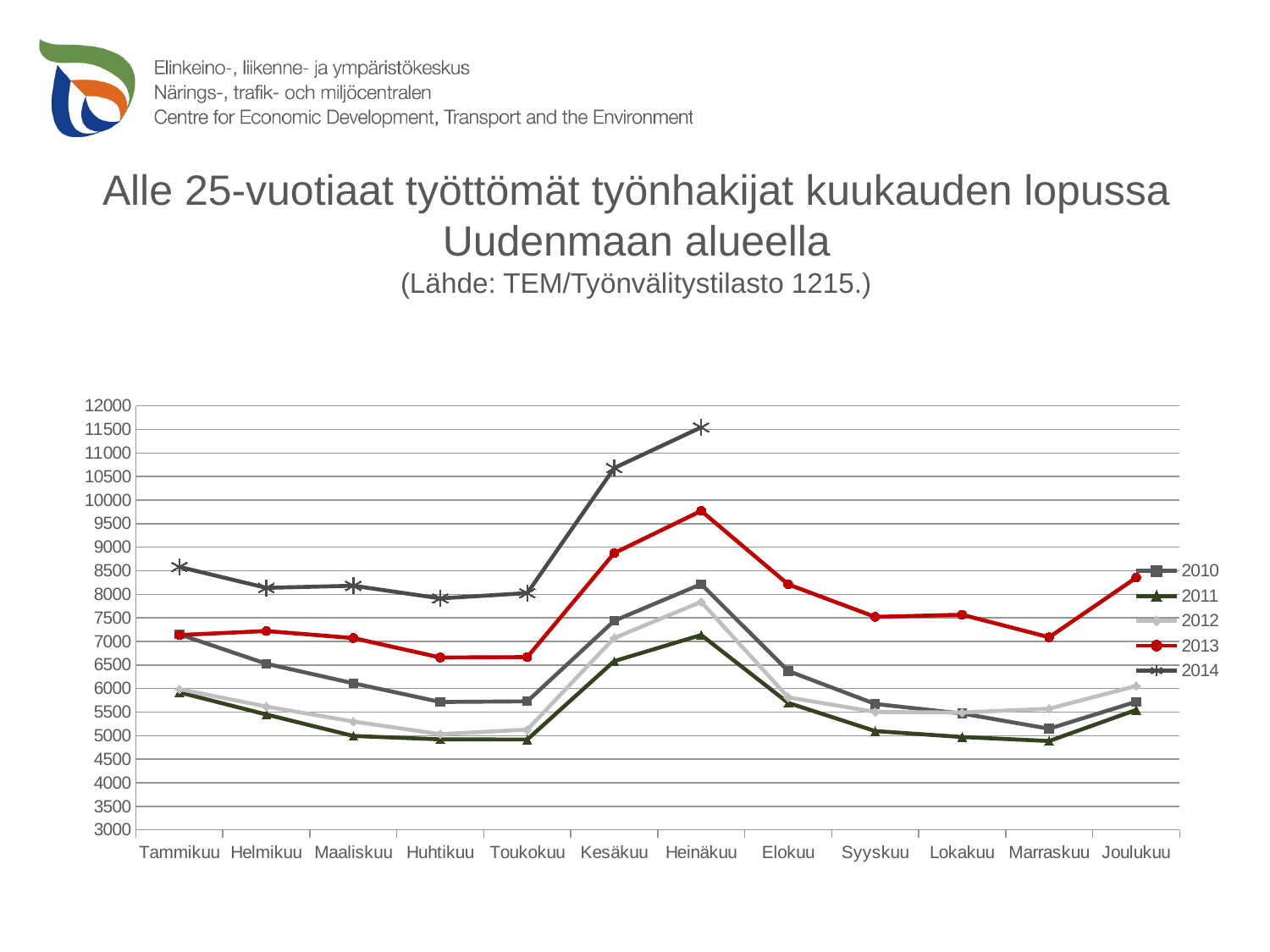
How many data points are plotted for the 2014 series? 7 In Joulukuu, which is larger: the value for 2013 or the value for 2010? 2013 Is the value for 2014 in Heinäkuu greater or less than 11000? greater Which series has the highest value in Heinäkuu? 2014 What kind of chart is shown on the slide? line chart How many series does the legend list? 5 How many months are shown on the x axis? 12 Does the 2013 series rise or fall from Heinäkuu to Marraskuu? fall In which month does the 2014 series reach its highest value? Heinäkuu In which month does the 2010 series reach its lowest value? Marraskuu Is the value for 2013 in Huhtikuu greater or less than 7000? less Is the value for 2010 in Kesäkuu greater or less than 7000? greater